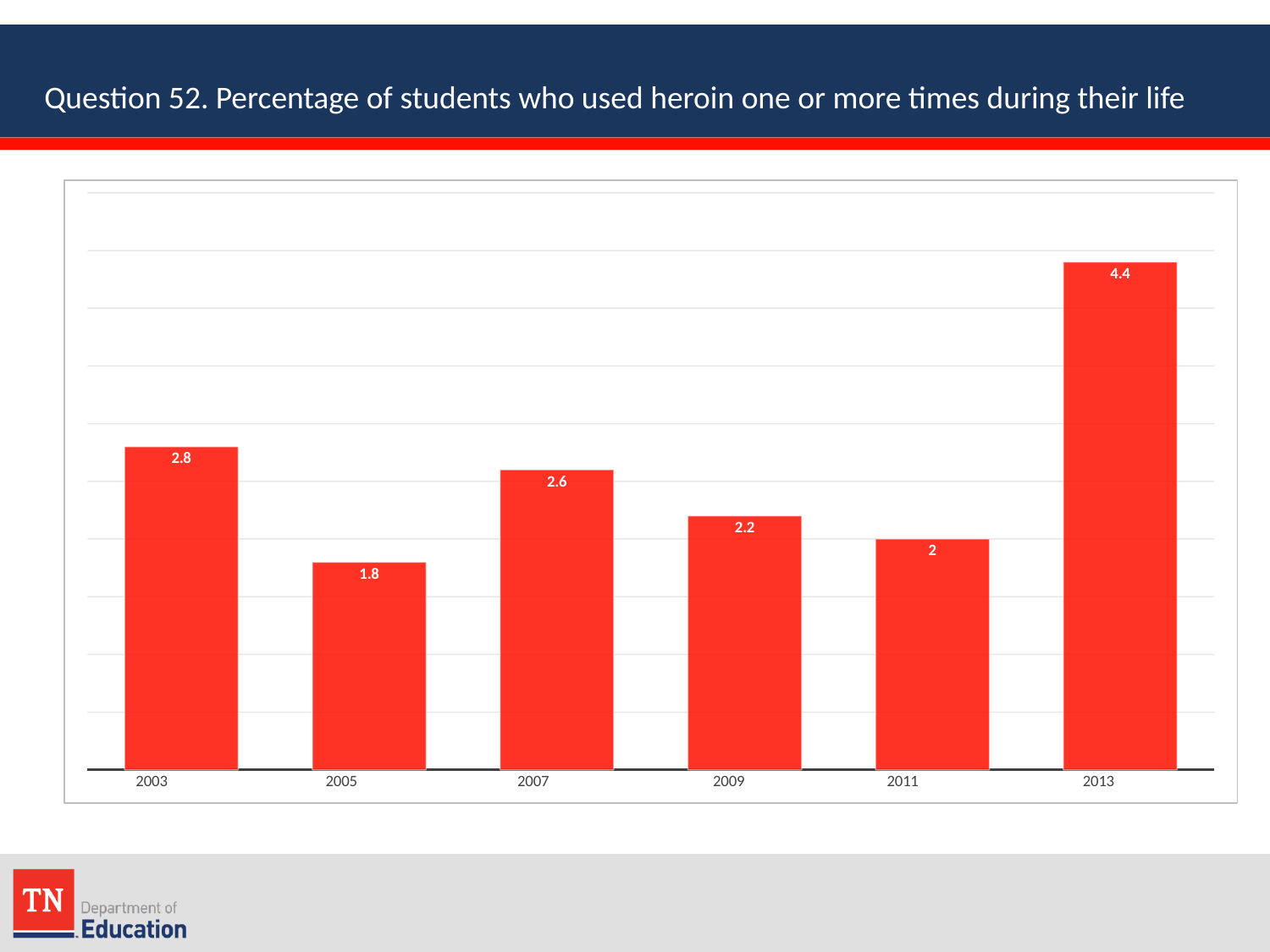
What is the value for 2013? 4.4 Which year has the lowest value? 2005 How many years are shown on the x axis? 6 What is the value for 2011? 2 Which is larger, the value for 2007 or the value for 2009? 2007 What is the value for 2005? 1.8 Which year has the highest value? 2013 What kind of chart is this? Bar chart What is the difference between the values for 2003 and 2005? 1 Do the values rise or fall from 2007 to 2011? Fall What is the value for 2003? 2.8 What is the difference between the values for 2013 and 2011? 2.4